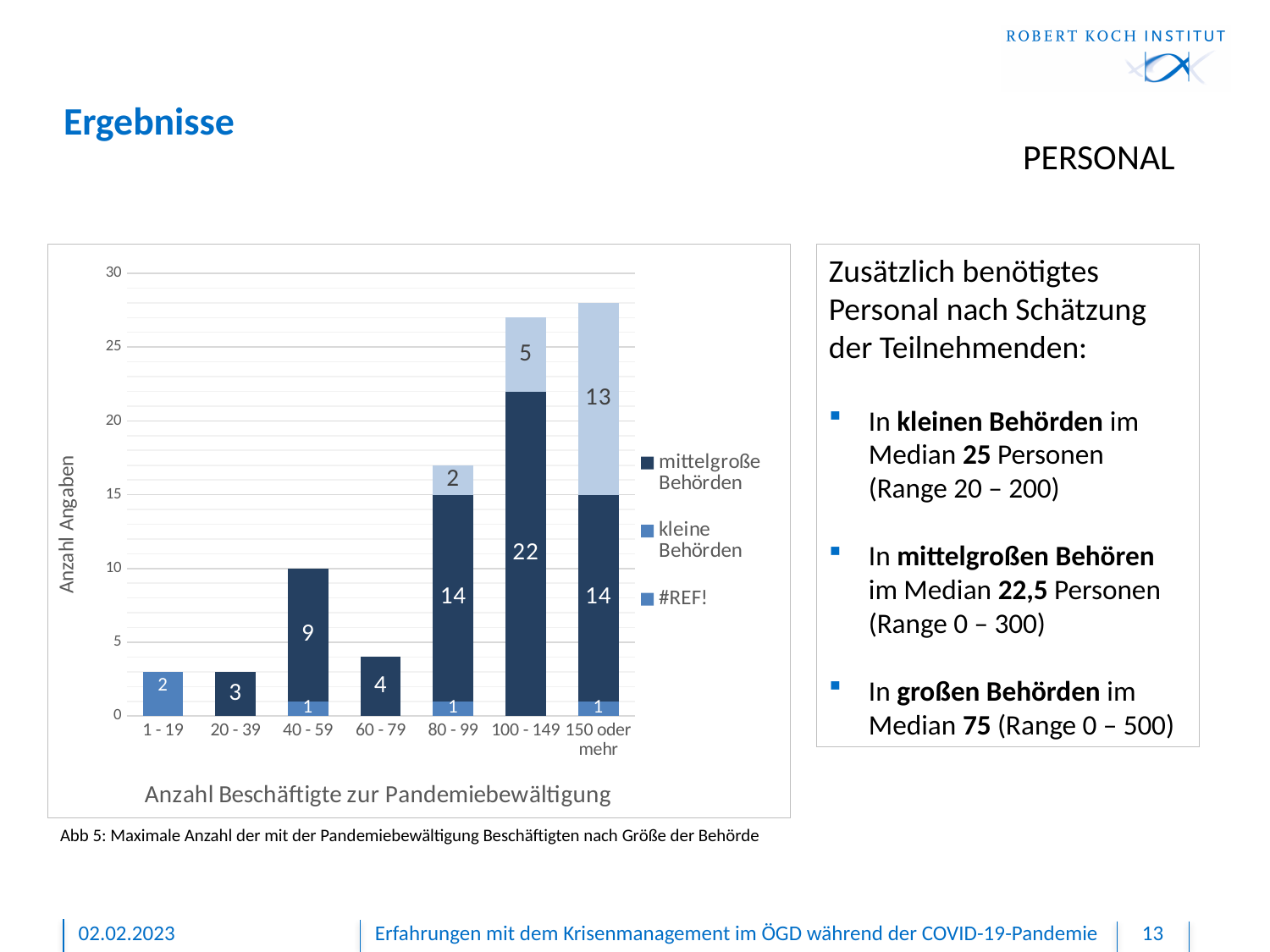
How many series does the legend list? 3 What is the value for mittelgroße Behörden in the 100 - 149 category? 22 How many categories are shown on the x axis? 7 What is the difference between the mittelgroße Behörden values for 100 - 149 and 80 - 99? 8 What is the value for mittelgroße Behörden in the 40 - 59 category? 9 What kind of chart is shown on the slide? Stacked bar chart What is the total of the stacked bar for 100 - 149? 27 What is the total of the stacked bar for 150 oder mehr? 28 Which category has the highest value for mittelgroße Behörden? 100 - 149